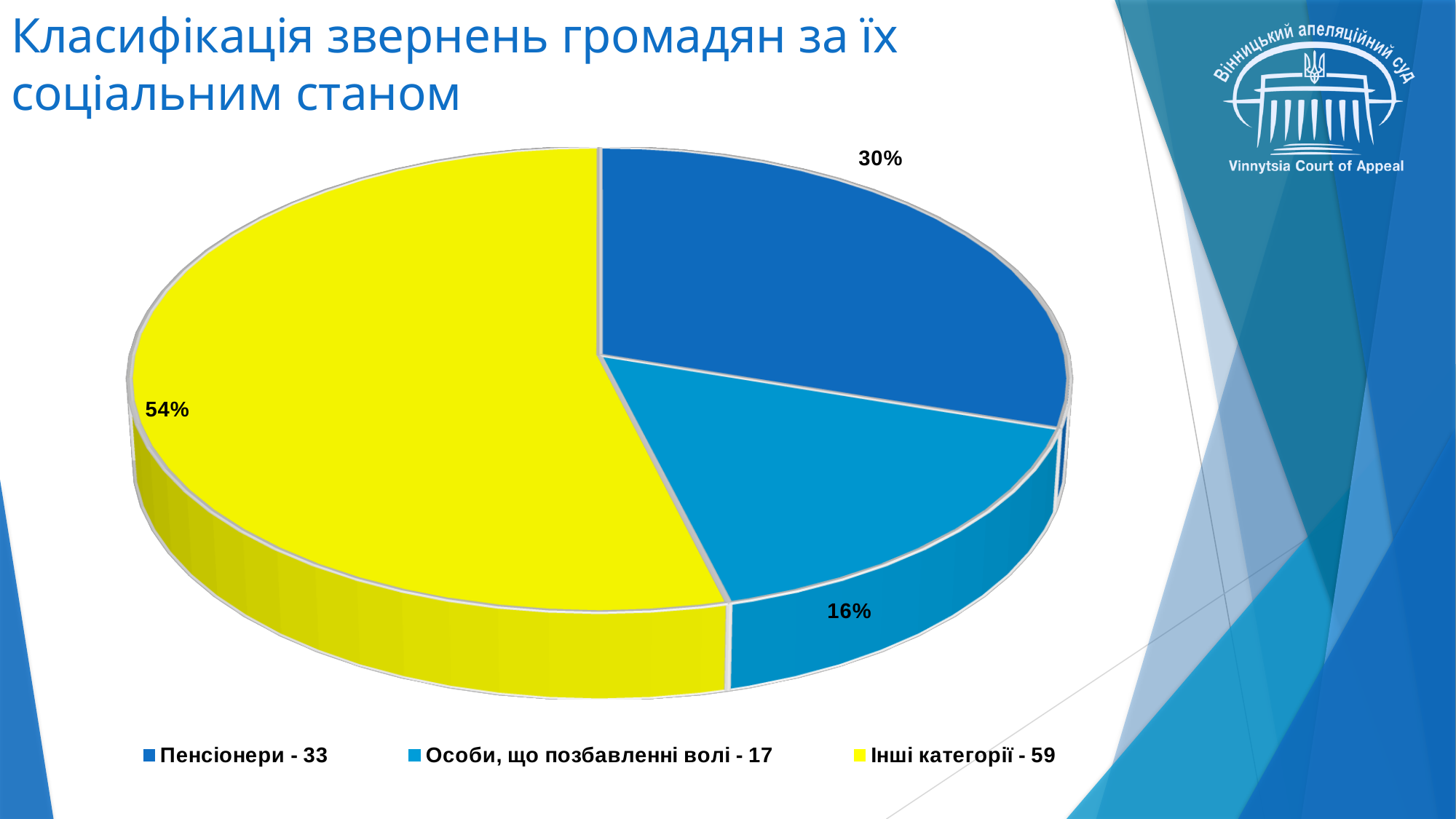
What is the title of the slide containing the chart? Класифікація звернень громадян за їх соціальним станом What percentage share does the "Пенсіонери - 33" slice have? 30% What colour is the "Інші категорії - 59" slice? yellow Which category has the smallest slice of the pie? Особи, що позбавленні волі - 17 Which slice is larger: "Пенсіонери" or "Особи, що позбавленні волі"? Пенсіонери What is the difference in percentage points between the "Пенсіонери" slice and the "Особи, що позбавленні волі" slice? 14 How many slices does the pie chart have? 3 What kind of chart is shown on the slide? pie chart What percentage share does the "Особи, що позбавленні волі - 17" slice have? 16% Which category has the largest slice of the pie? Інші категорії - 59 What is the difference in percentage points between the "Інші категорії" slice and the "Пенсіонери" slice? 24 What percentage share does the "Інші категорії - 59" slice have? 54%